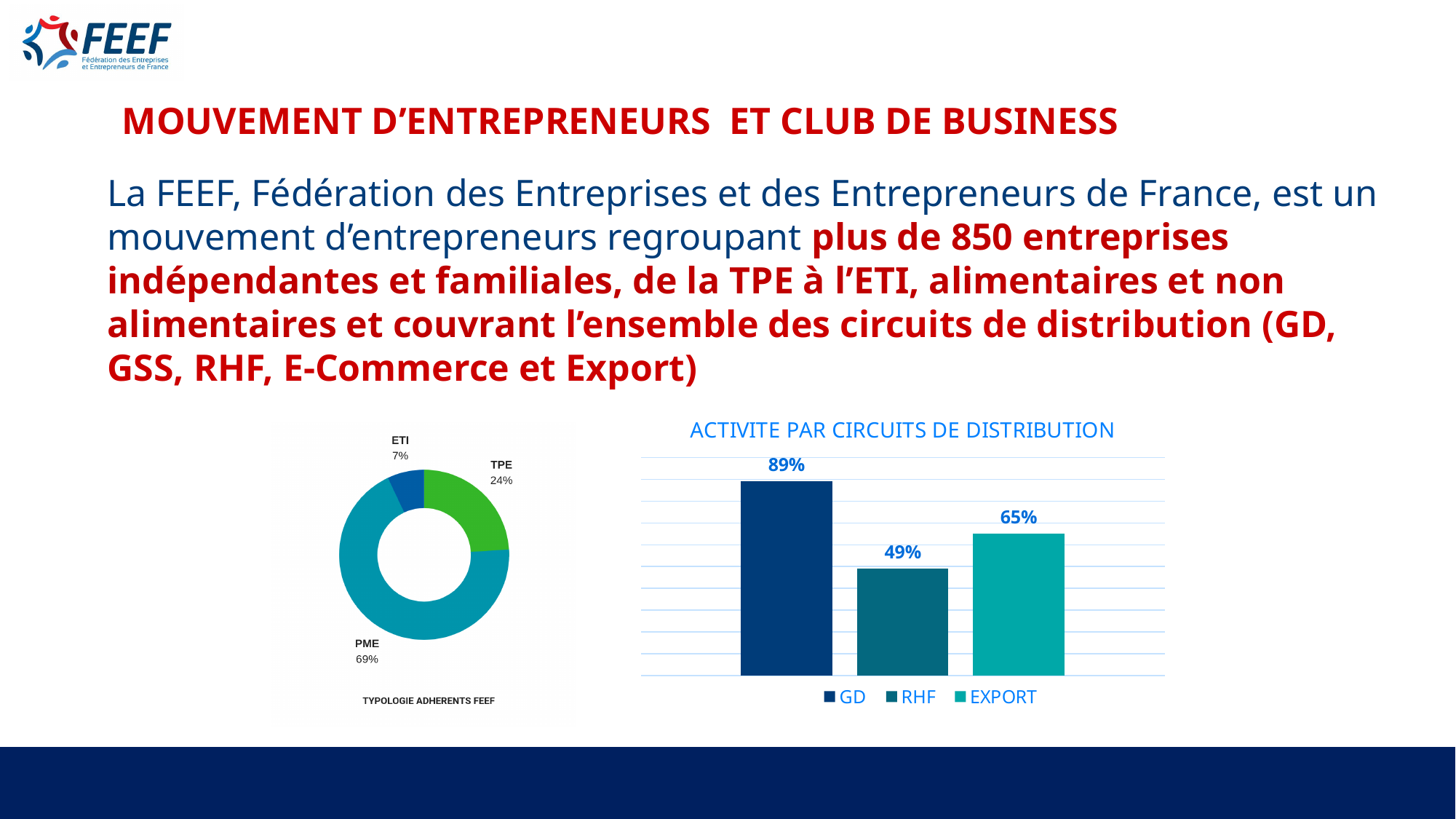
What kind of chart is 'TYPOLOGIE ADHERENTS FEEF'? Doughnut chart In the 'TYPOLOGIE ADHERENTS FEEF' chart, what share is ETI? 7% In the 'ACTIVITE PAR CIRCUITS DE DISTRIBUTION' chart, what is the difference between GD and EXPORT? 24% In the 'ACTIVITE PAR CIRCUITS DE DISTRIBUTION' chart, which circuit has the lowest value? RHF What kind of chart is 'ACTIVITE PAR CIRCUITS DE DISTRIBUTION'? Bar chart In the 'TYPOLOGIE ADHERENTS FEEF' chart, what share is PME? 69% In the 'TYPOLOGIE ADHERENTS FEEF' chart, how many categories are shown? 3 In the 'ACTIVITE PAR CIRCUITS DE DISTRIBUTION' chart, what is the value for RHF? 49% In the 'ACTIVITE PAR CIRCUITS DE DISTRIBUTION' chart, which is larger, RHF or EXPORT? EXPORT In the 'ACTIVITE PAR CIRCUITS DE DISTRIBUTION' chart, what is the value for GD? 89% In the 'TYPOLOGIE ADHERENTS FEEF' chart, which category has the smallest share? ETI In the 'TYPOLOGIE ADHERENTS FEEF' chart, which category has the largest share? PME